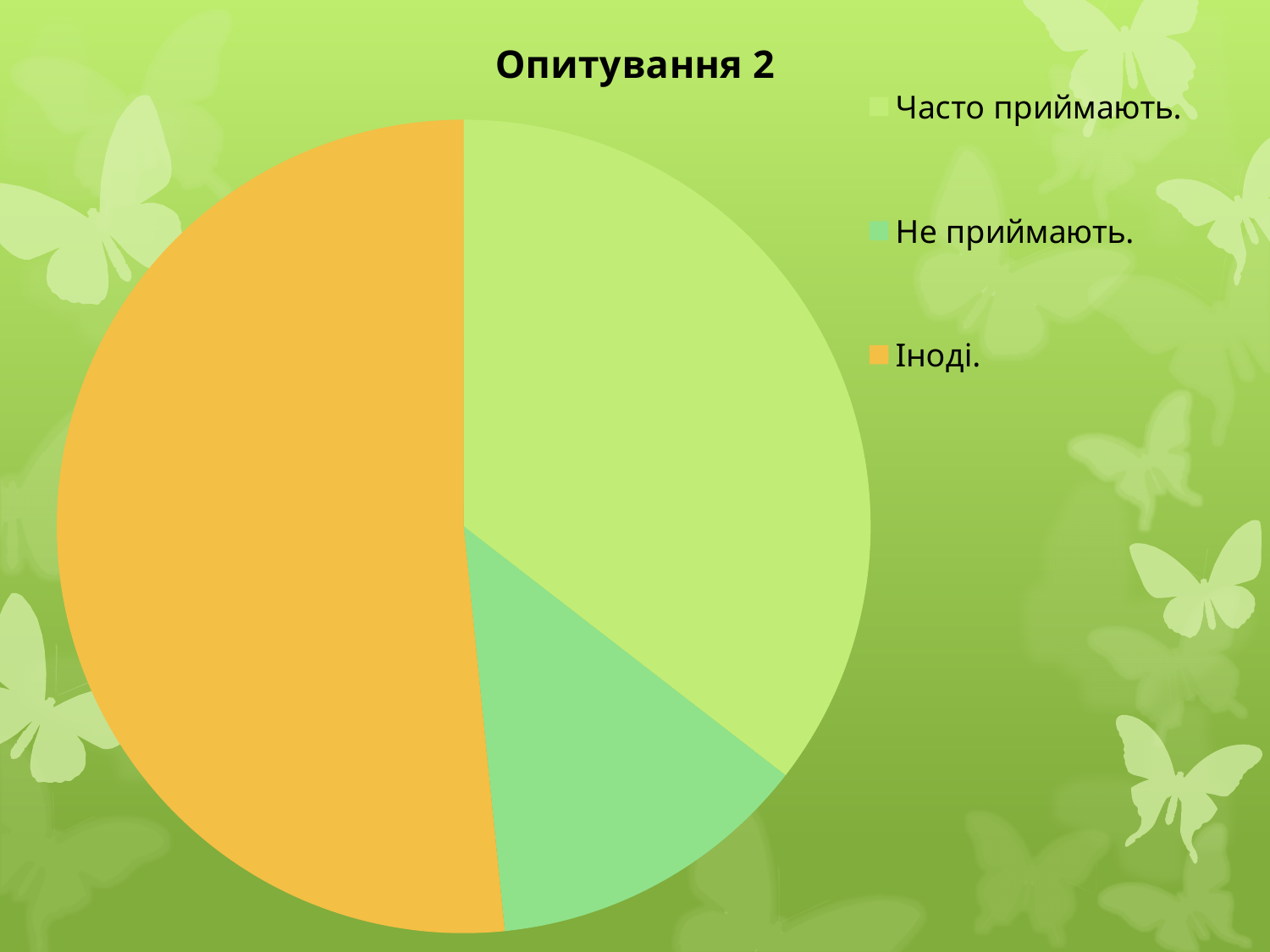
Which slice is larger: "Іноді." or "Часто приймають."? Іноді. Which colour represents the "Іноді." category in the pie chart? orange How many entries does the legend list? 3 Which category has the smallest slice of the pie? Не приймають. What kind of chart is shown on the slide? pie chart Which slice is larger: "Часто приймають." or "Не приймають."? Часто приймають. How many slices does the pie chart have? 3 Which category has the largest slice of the pie? Іноді. What is the title of the chart? Опитування 2